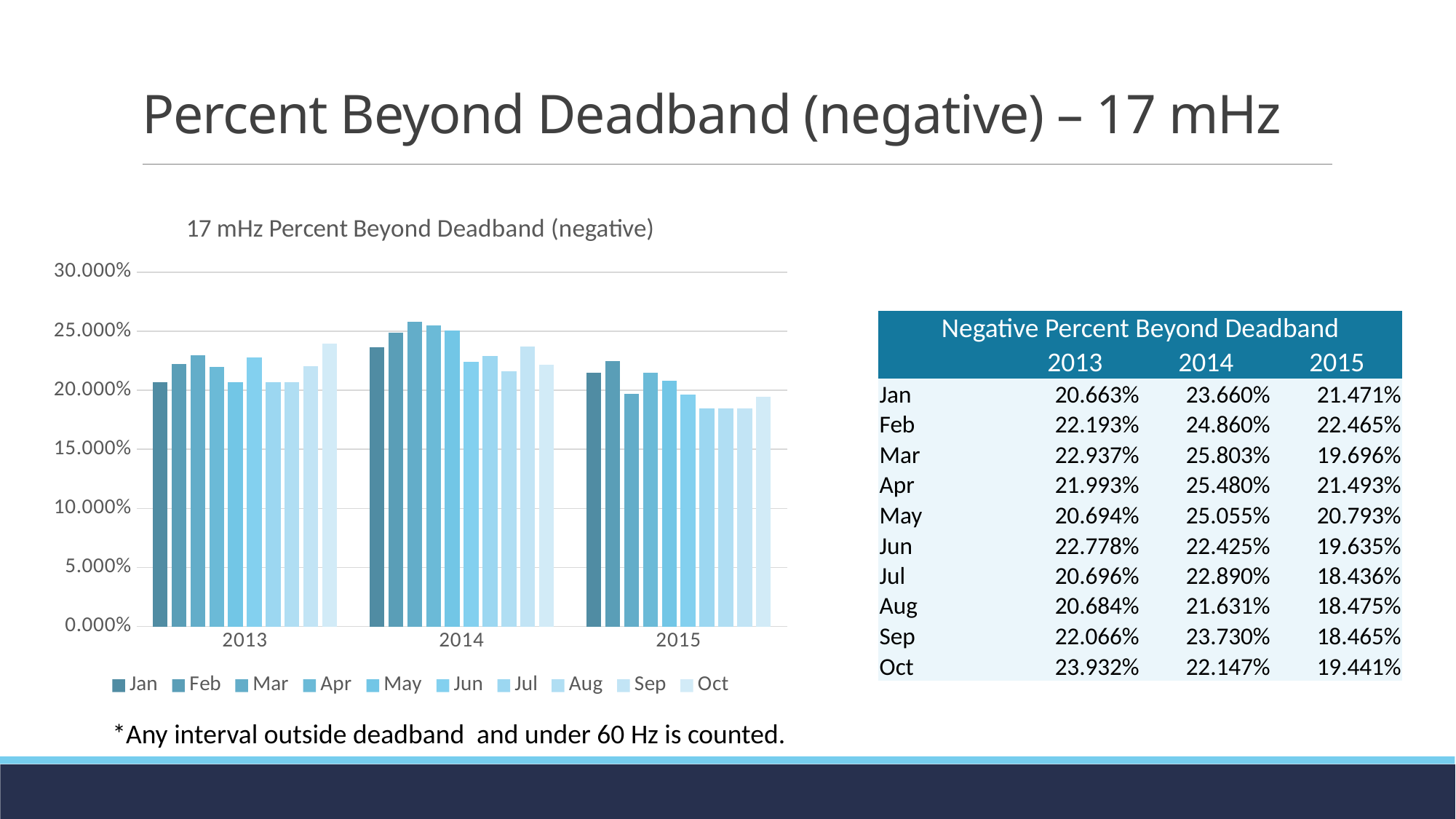
How many year categories are shown on the x axis of the chart? 3 What is the value for Jan in 2014? 23.660% How many series does the chart legend list? 10 What is the value for Oct in 2013? 23.932% Which is larger, the Feb value in 2013 or the Feb value in 2014? 2014 Which month has the highest value in 2015? Feb What kind of chart is shown on the slide? bar chart Which month has the highest value in 2013? Oct What is the title of the chart? 17 mHz Percent Beyond Deadband (negative) Is the value for Jul in 2015 greater or less than 20.000%? less What is the difference between the Oct and Jan values in 2013? 3.269% What is the value for Jul in 2015? 18.436%